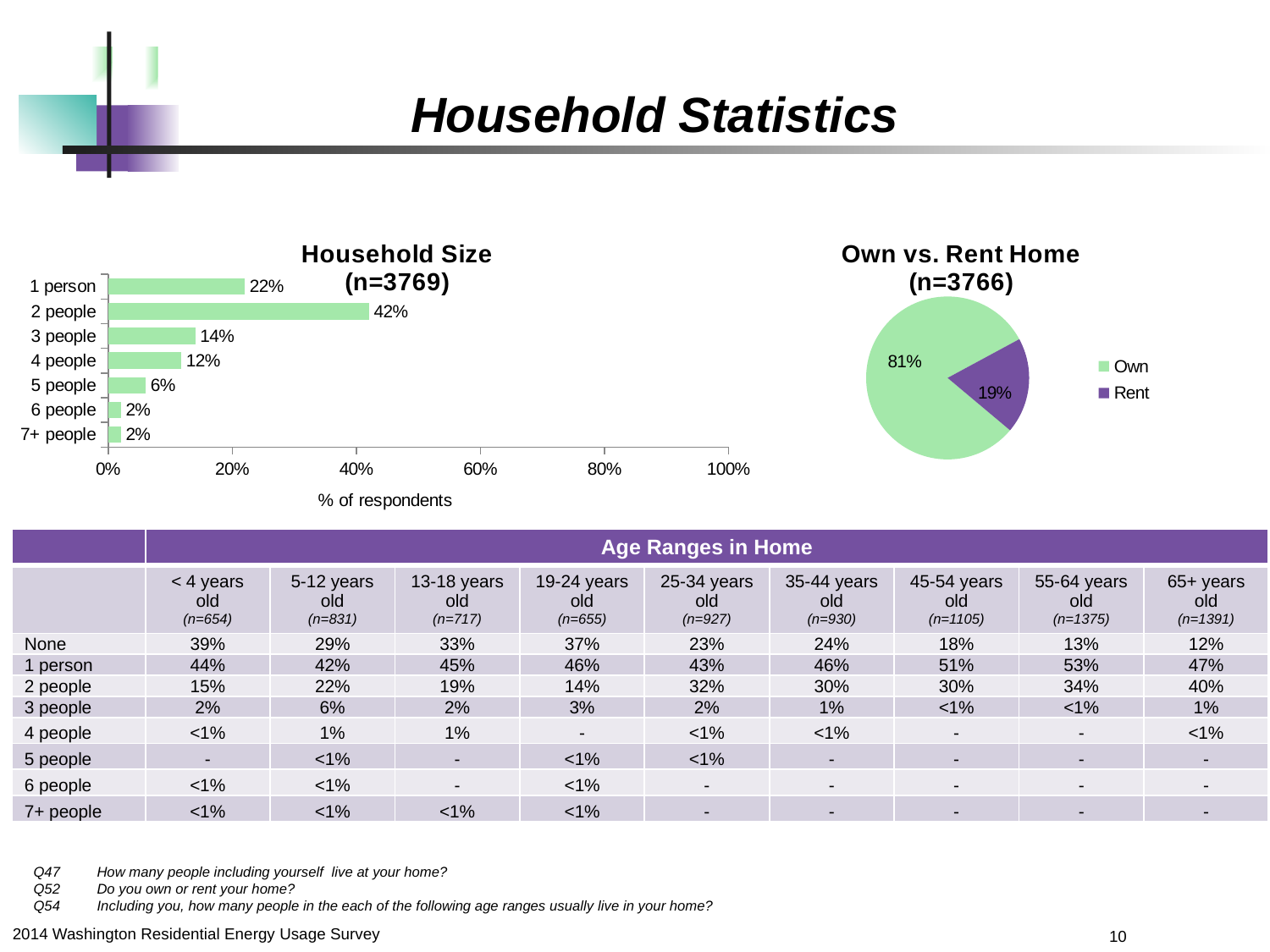
In the Own vs. Rent Home chart, what share of respondents rent their home? 19% What kind of chart is the Own vs. Rent Home chart? Pie chart In the Household Size chart, what is the value for 1 person? 22% How many series does the legend of the Own vs. Rent Home chart list? 2 In the Household Size chart, what is the difference between the values for 2 people and 1 person? 20% In the Household Size chart, which is larger, the value for 3 people or the value for 4 people? 3 people What kind of chart is the Household Size chart? Bar chart In the Household Size chart, what percentage of respondents have 2 people in the household? 42% In the Household Size chart, which household size category has the highest percentage? 2 people In the Household Size chart, what is the x-axis label? % of respondents In the Own vs. Rent Home chart, what share of respondents own their home? 81% In the Household Size chart, how many household size categories are shown? 7